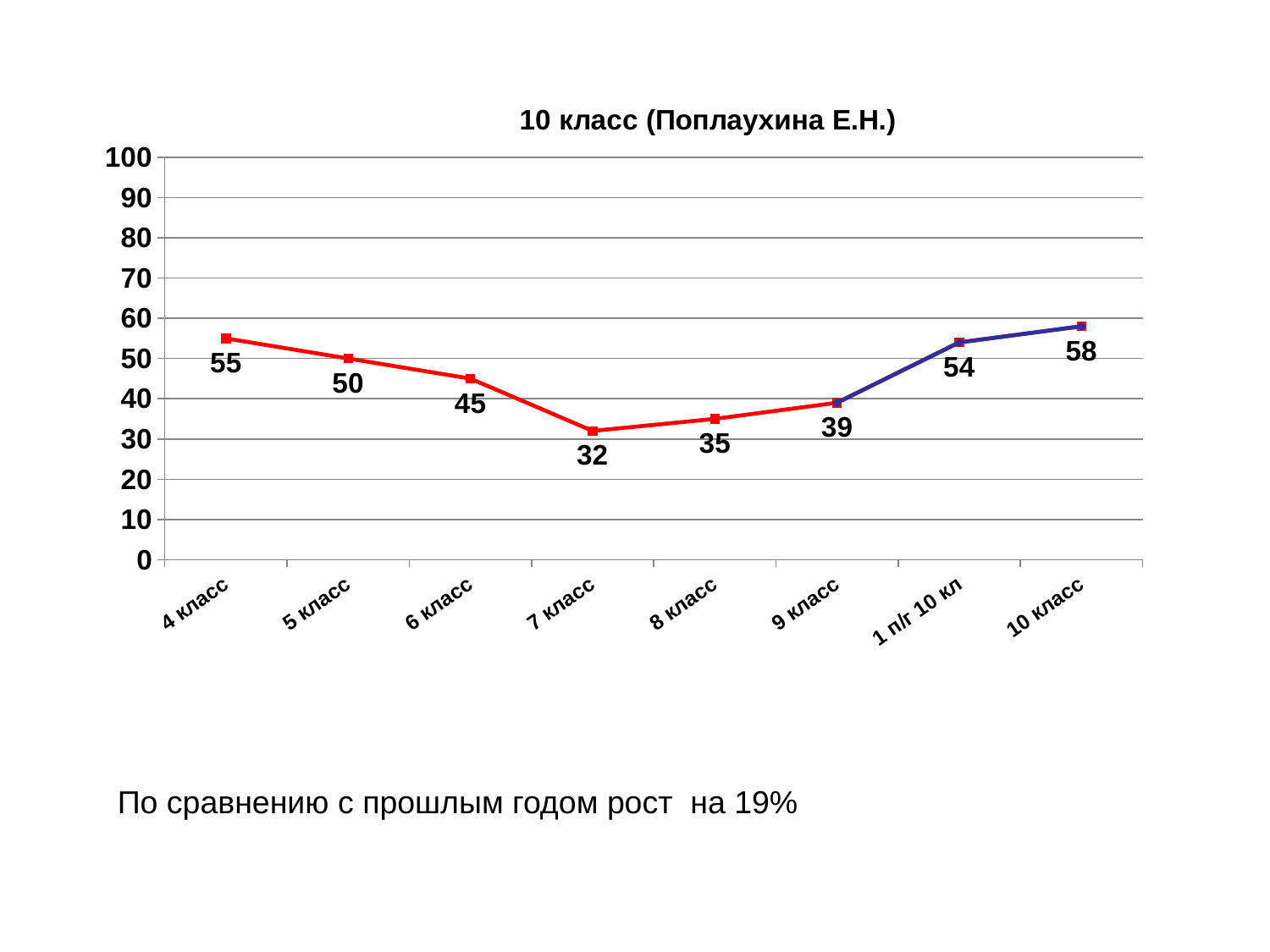
What is the title of the chart? 10 класс (Поплаухина Е.Н.) What is the value for 4 класс? 55 What is the value for 1 п/г 10 кл? 54 What kind of chart is this? line chart Which is larger, the value for 5 класс or the value for 8 класс? 5 класс How many categories are shown on the x axis? 8 What is the difference between the values for 4 класс and 7 класс? 23 Which category has the lowest value? 7 класс Which category has the highest value? 10 класс What is the difference between the values for 10 класс and 9 класс? 19 What is the value for 7 класс? 32 Is the value for 6 класс greater or less than 40? greater